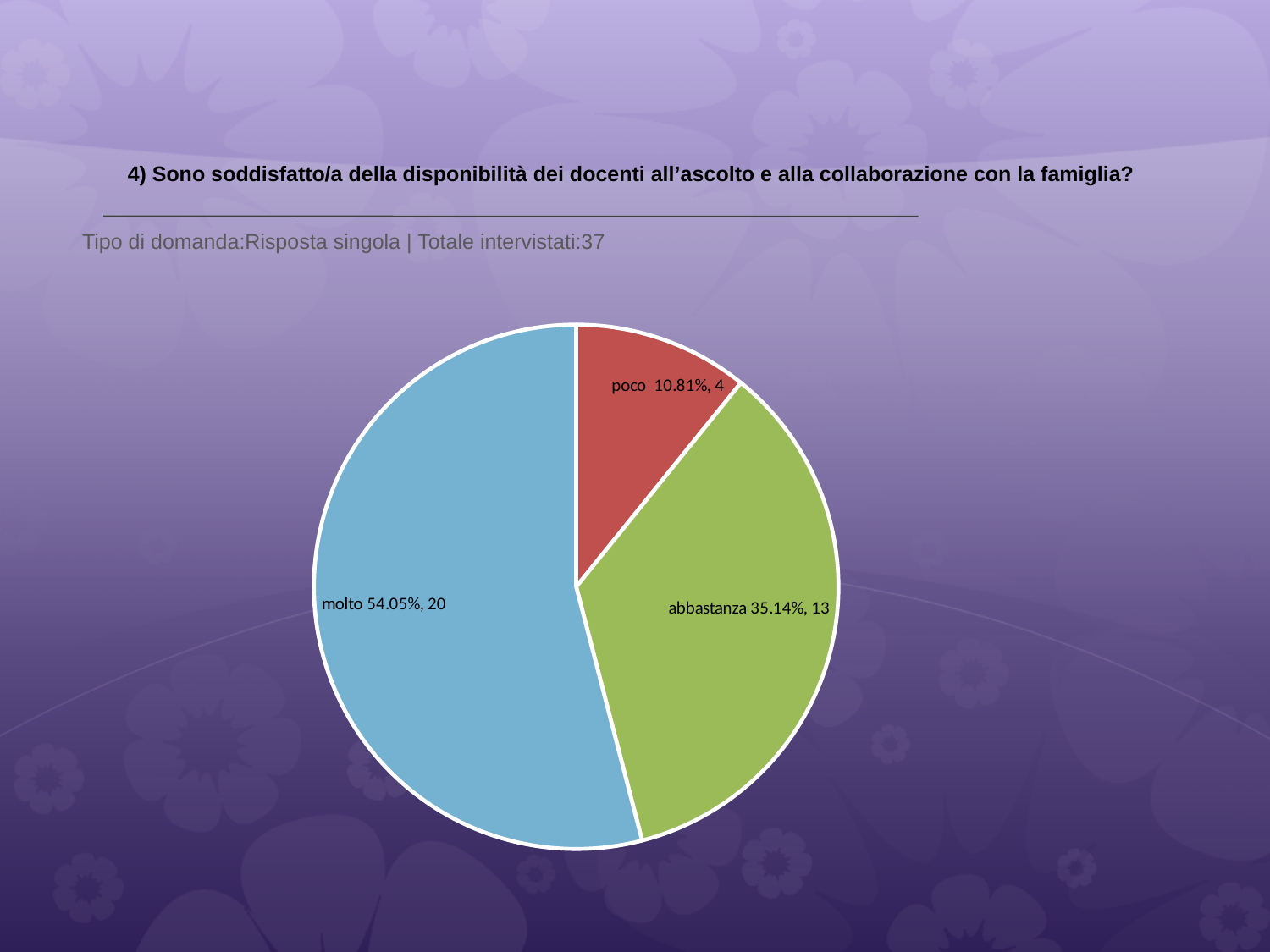
How many respondents answered 'poco'? 4 How many respondents answered 'abbastanza'? 13 What is the difference in the number of respondents between 'molto' and 'abbastanza'? 7 What percentage share does the 'abbastanza' slice have? 35.14% How many respondents answered 'molto'? 20 Which slice is larger, 'abbastanza' or 'poco'? abbastanza What percentage share does the 'poco' slice have? 10.81% How many slices does the pie chart have? 3 What percentage share does the 'molto' slice have? 54.05% Which response has the smallest slice of the pie? poco Which response has the largest slice of the pie? molto What kind of chart is shown on the slide? pie chart